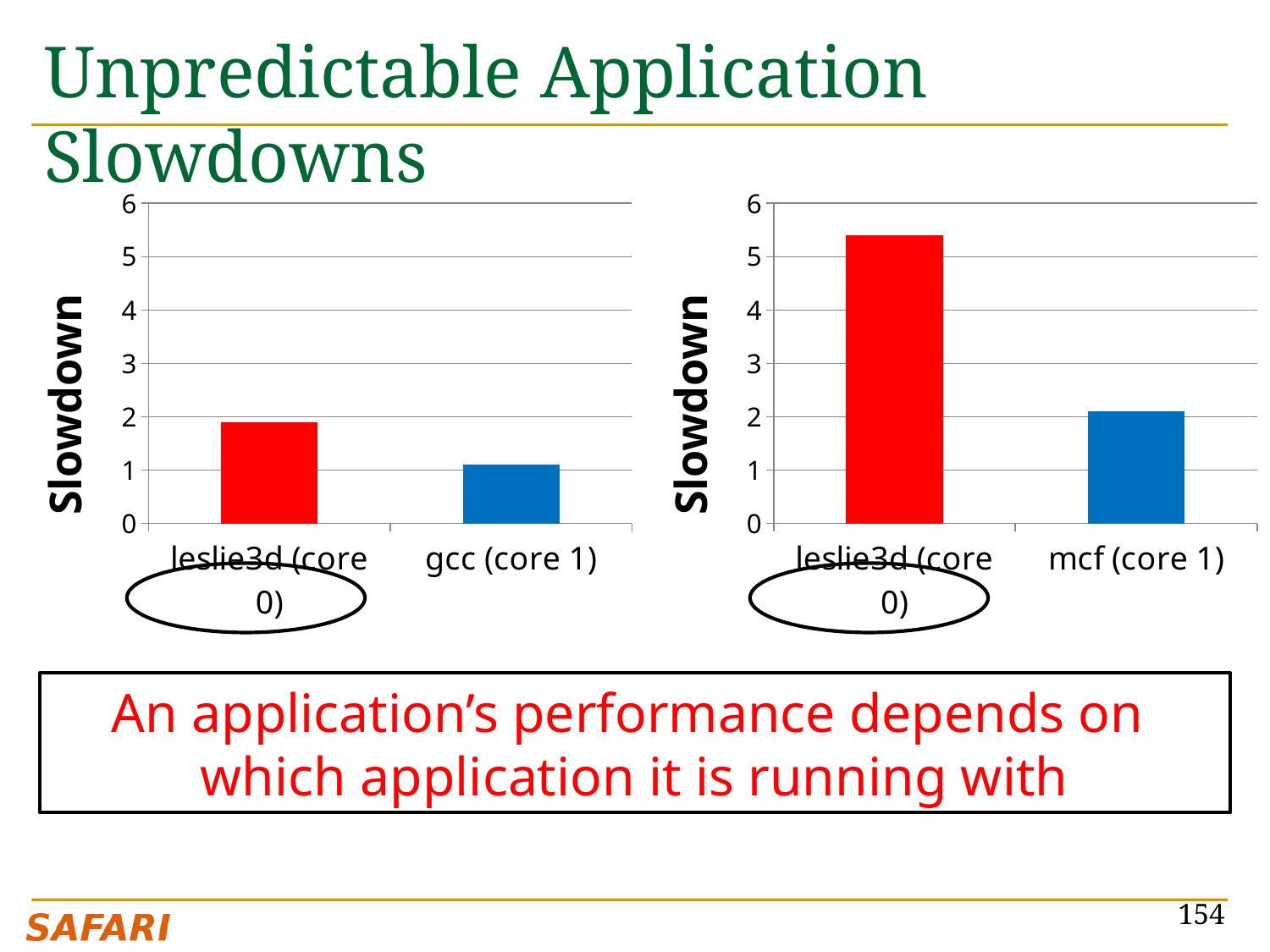
In the right chart, is the slowdown for mcf (core 1) greater or less than 3? less How many bars are shown in the left chart? 2 In the left chart, is the slowdown for gcc (core 1) greater or less than 2? less What is the y-axis label of the right chart? Slowdown What kind of chart is the left chart on the slide? bar chart In the left chart, which category has the lower slowdown? gcc (core 1) In the right chart, is the slowdown for leslie3d (core 0) greater or less than 5? greater Is the slowdown of leslie3d (core 0) larger in the left chart or in the right chart? right chart In the left chart, which category has the higher slowdown? leslie3d (core 0) In the right chart, which category has the higher slowdown? leslie3d (core 0) In the right chart, which category has the lower slowdown? mcf (core 1)